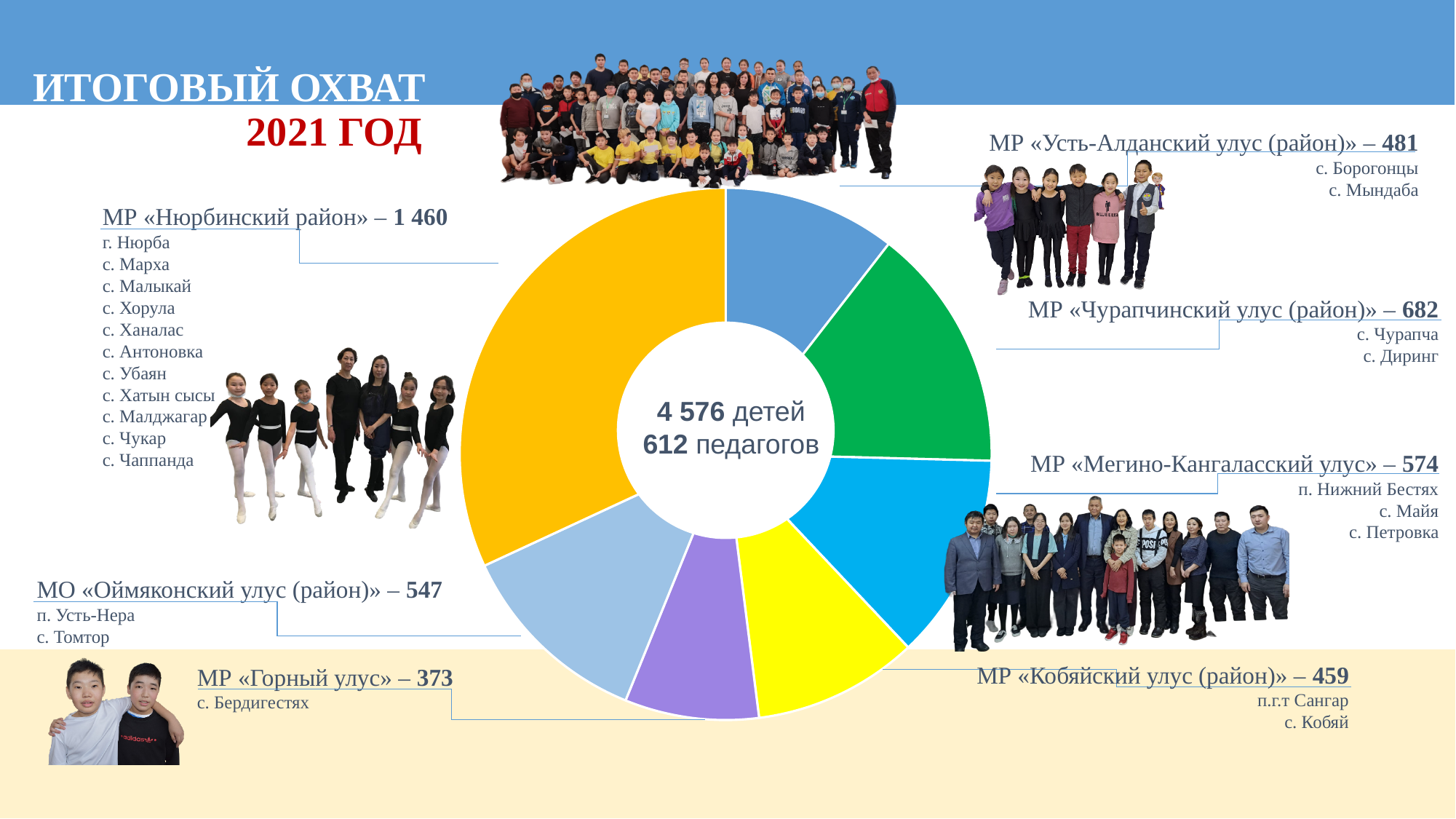
What is the value for МР «Горный улус»? 373 What is the value for МР «Чурапчинский улус (район)»? 682 How many districts (segments) does the chart show? 7 Which district has the lowest value? МР «Горный улус» What is the value for МР «Нюрбинский район»? 1 460 Which is larger: МР «Мегино-Кангаласский улус» or МР «Кобяйский улус (район)»? МР «Мегино-Кангаласский улус» Which district has the highest value? МР «Нюрбинский район» How many teachers (педагогов) are stated in the centre of the chart? 612 What kind of chart is shown on the slide? Pie (donut) chart What is the difference between МР «Нюрбинский район» and МР «Чурапчинский улус (район)»? 778 What is the value for МО «Оймяконский улус (район)»? 547 What total number of children is shown in the centre of the chart? 4 576 детей